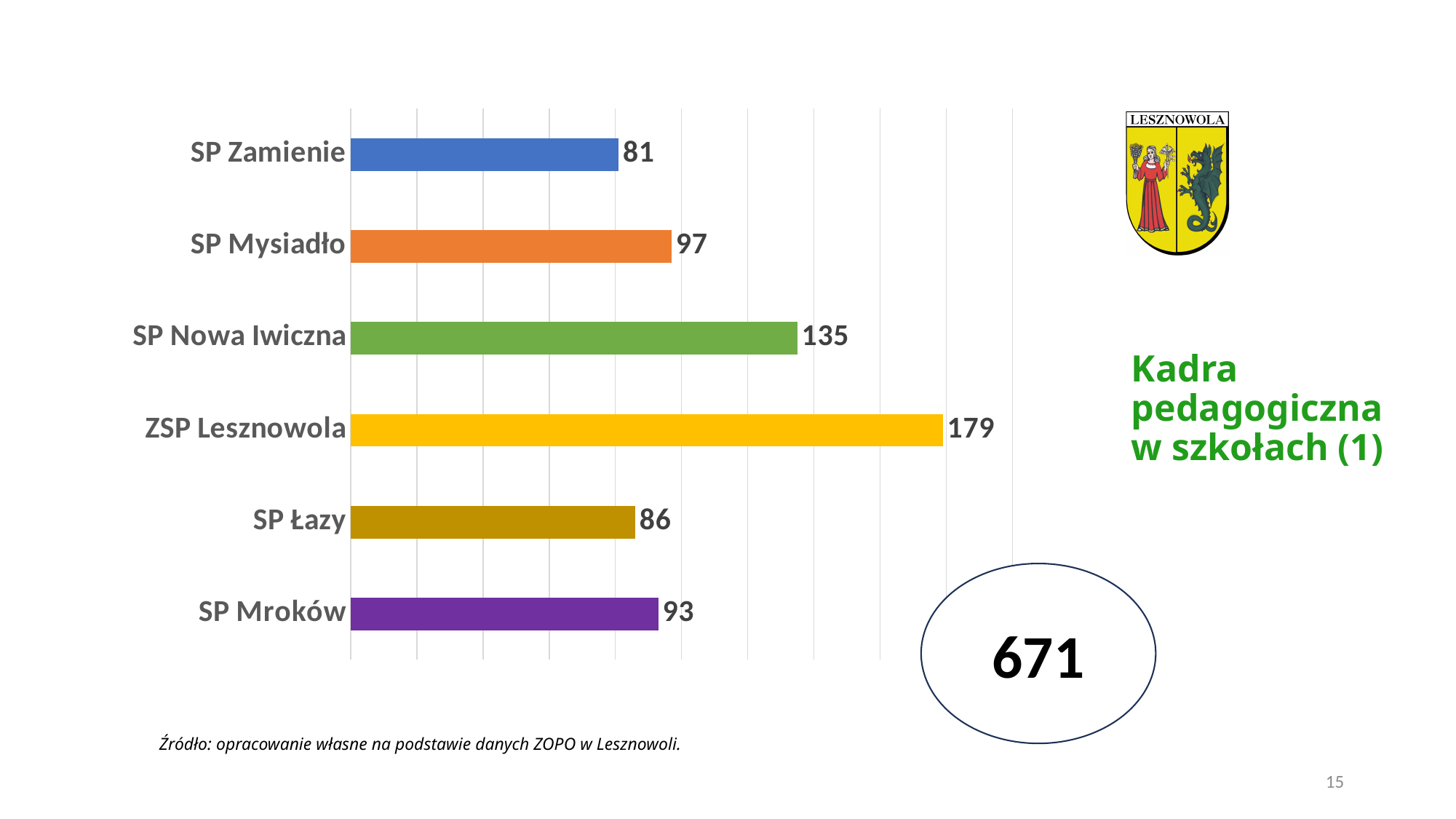
What is the difference between the values for SP Mysiadło and SP Łazy? 11 How many schools are shown in the chart? 6 What kind of chart is shown on the slide? Bar chart What is the value for SP Nowa Iwiczna? 135 What is the value for SP Zamienie? 81 What is the value for SP Mroków? 93 What is the value for ZSP Lesznowola? 179 Which is larger, the value for SP Mroków or the value for SP Łazy? SP Mroków Which school has the highest value? ZSP Lesznowola Which school has the lowest value? SP Zamienie What is the difference between the values for ZSP Lesznowola and SP Nowa Iwiczna? 44 What total number is shown in the circle next to the chart? 671